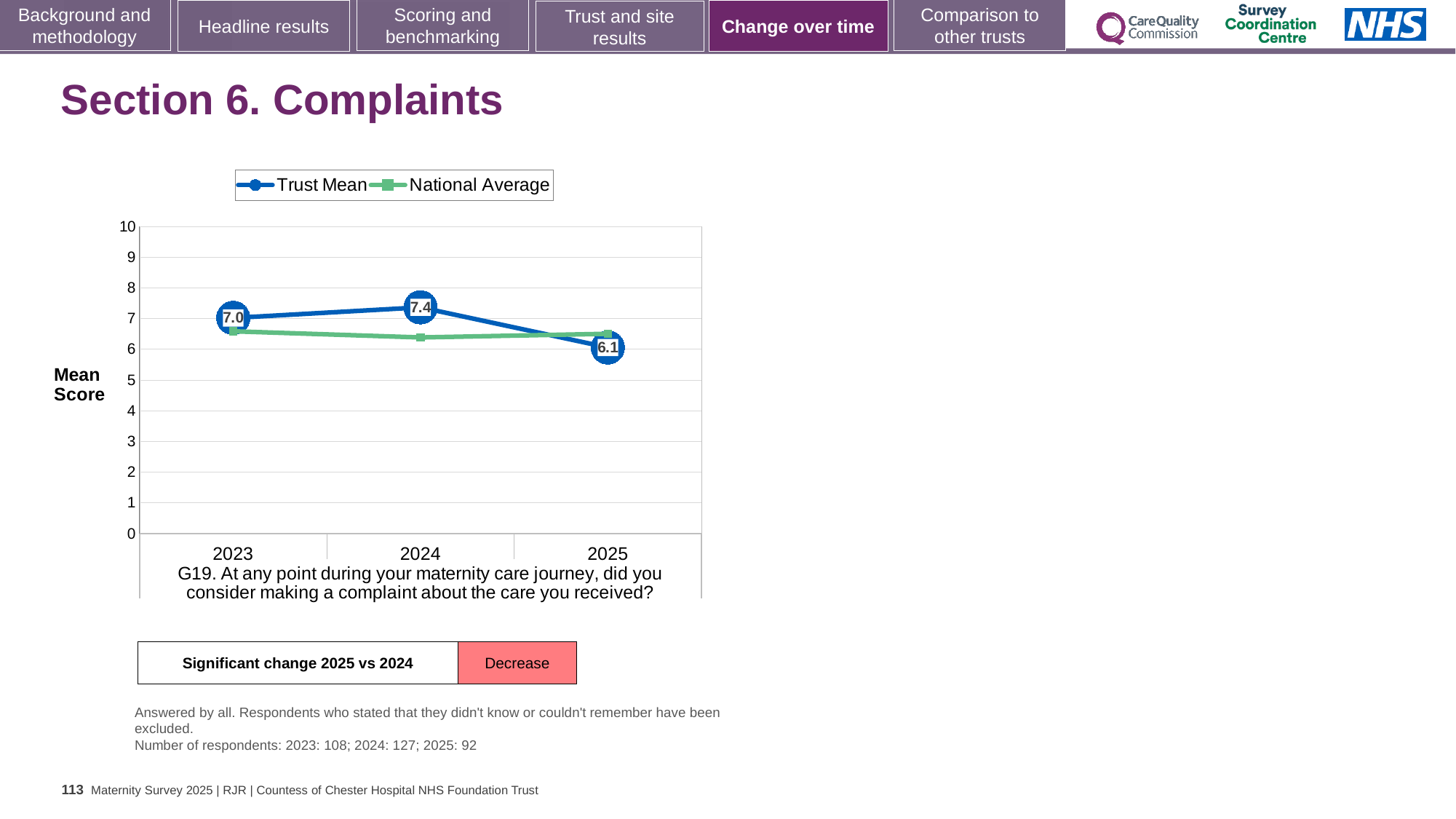
Does the Trust Mean rise or fall from 2024 to 2025? fall In which year is the Trust Mean highest? 2024 How many years are plotted on the x axis? 3 Is the National Average for 2023 greater or less than 6? greater In 2025, which is larger: the Trust Mean or the National Average? National Average What is the difference between the Trust Mean in 2024 and in 2025? 1.3 What is the Trust Mean score for 2025? 6.1 How many series does the legend list? 2 What is the Trust Mean score for 2023? 7.0 What is the Trust Mean score for 2024? 7.4 What kind of chart is shown on the slide? line chart In which year is the Trust Mean lowest? 2025